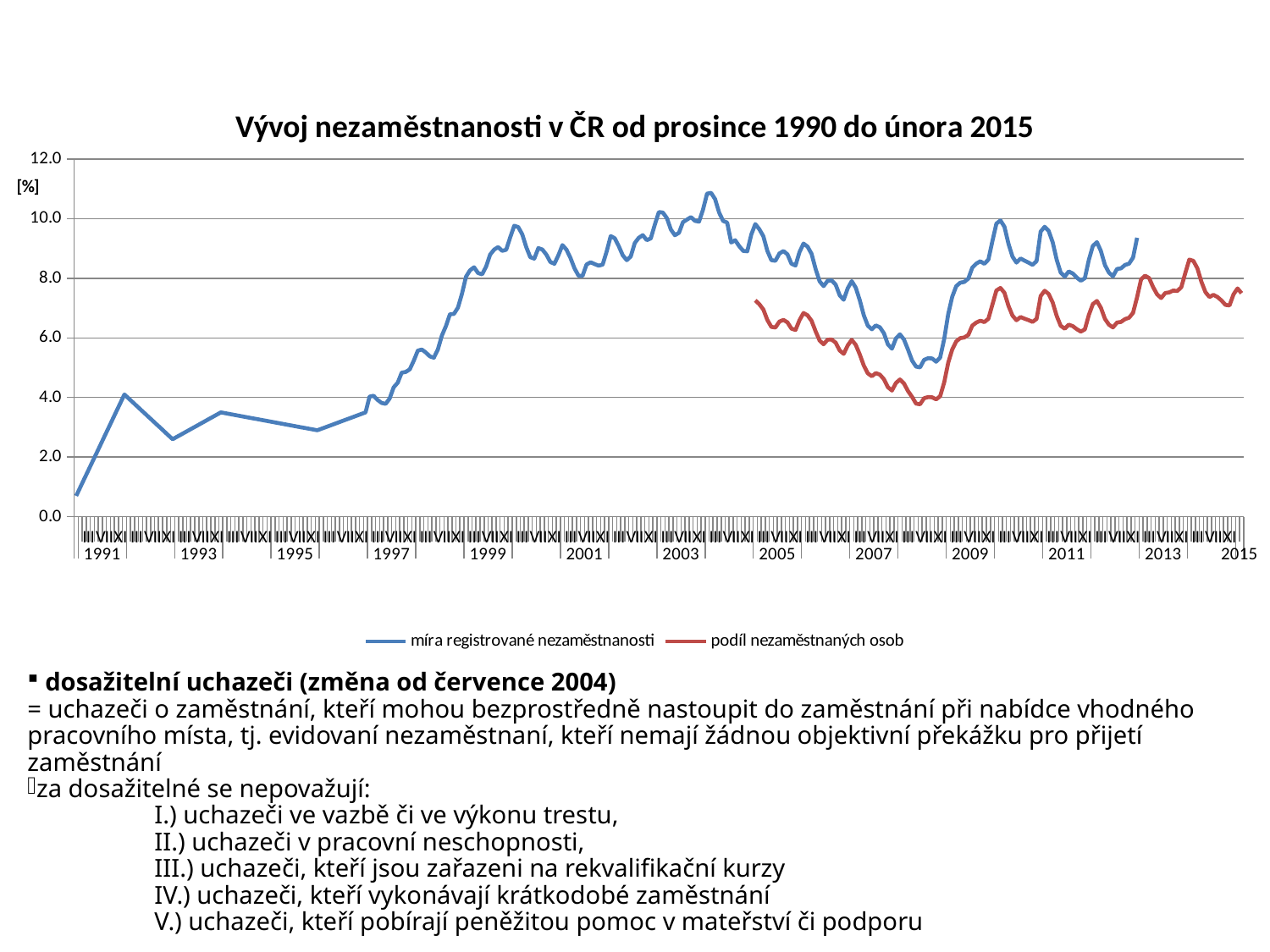
What kind of chart is shown on the slide? line chart In 2005, which series has the higher value: míra registrované nezaměstnanosti or podíl nezaměstnaných osob? míra registrované nezaměstnanosti Is the lowest value of the red line (podíl nezaměstnaných osob) around 2008 greater or less than 6.0? less What is the title of the chart? Vývoj nezaměstnanosti v ČR od prosince 1990 do února 2015 How many series does the legend list? 2 Does the blue line (míra registrované nezaměstnanosti) generally rise or fall between 2004 and 2008? fall Is the peak value of the blue line (míra registrované nezaměstnanosti) around 2004 greater or less than 10.0? greater Is the value of the blue line (míra registrované nezaměstnanosti) in 1995 greater or less than 4.0? less Does the blue line (míra registrované nezaměstnanosti) generally rise or fall between 1995 and 1999? rise Which series is drawn in red according to the legend? podíl nezaměstnaných osob